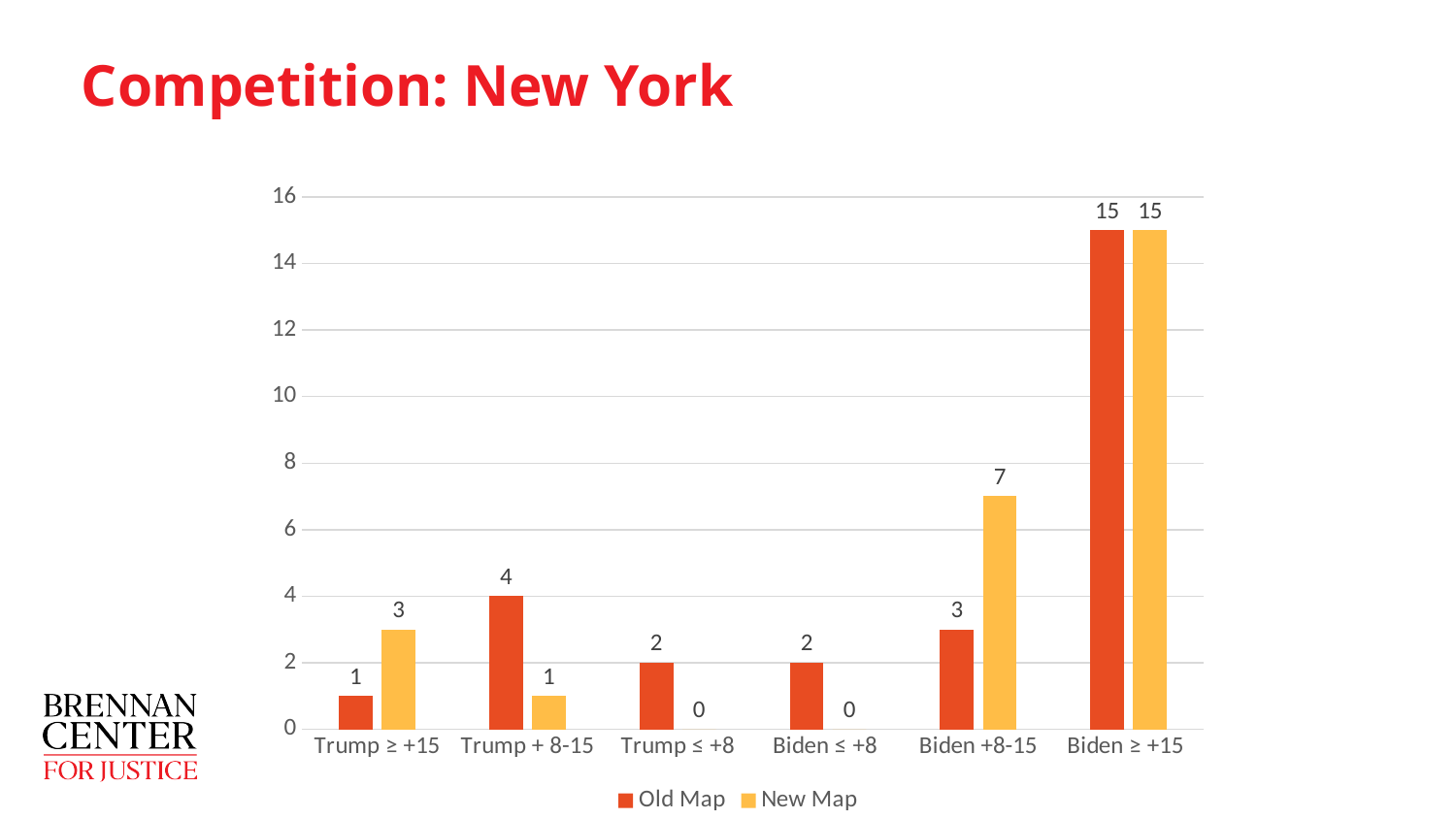
What is the Old Map value for Trump + 8-15? 4 What is the New Map value for Biden +8-15? 7 Which category has the highest Old Map value? Biden ≥ +15 What is the title of the slide? Competition: New York Which is larger for Trump + 8-15, the Old Map value or the New Map value? Old Map What is the New Map value for Trump ≥ +15? 3 What kind of chart is shown on the slide? bar chart What is the difference between the New Map and Old Map values for Biden +8-15? 4 Which category has the lowest Old Map value? Trump ≥ +15 Is the Old Map value for Biden ≥ +15 greater or less than 10? greater How many series does the legend list? 2 How many categories are shown on the x axis? 6